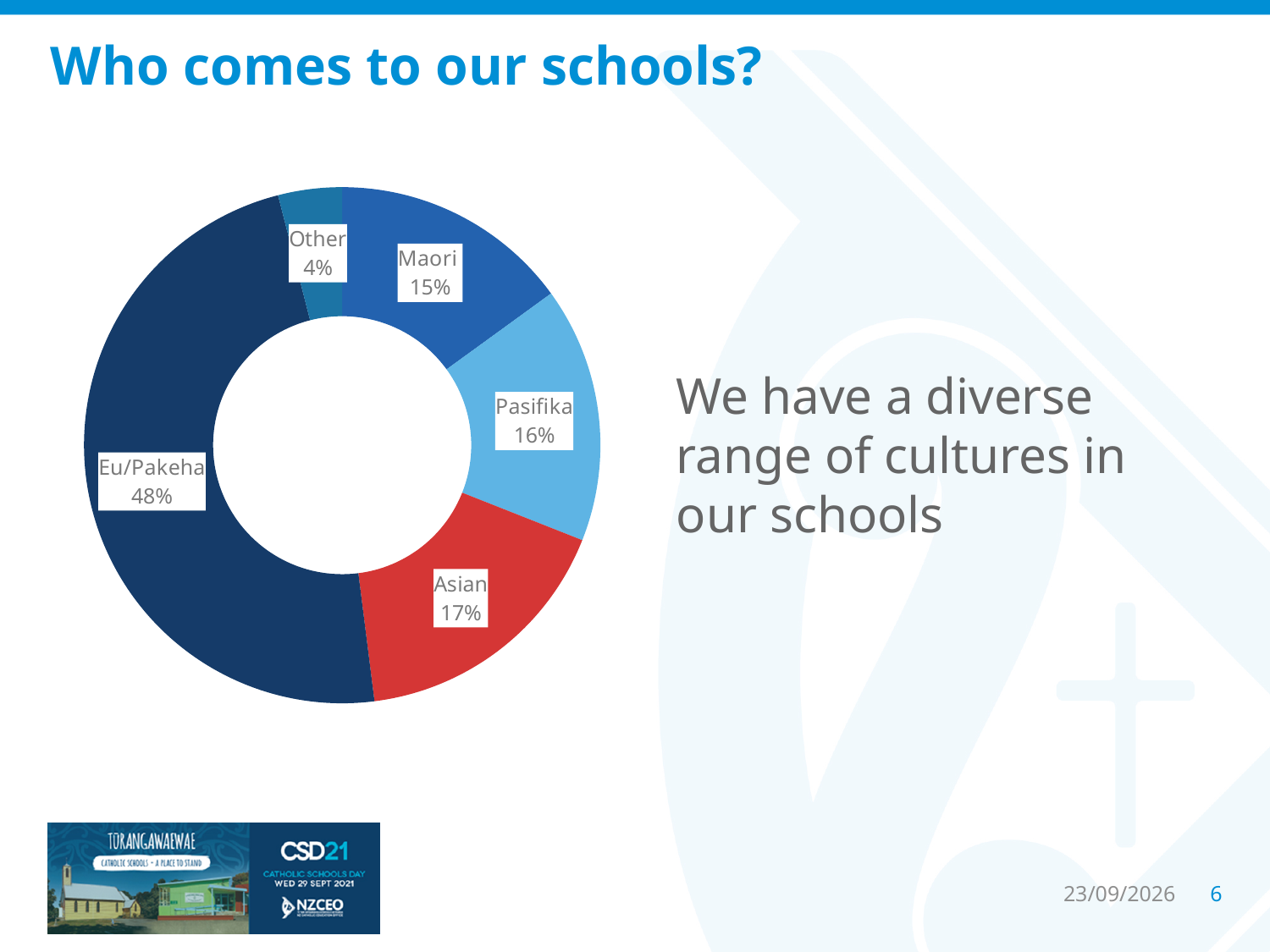
What colour is the Asian segment of the chart? Red How many categories are shown in the chart? 5 What is the difference in percentage points between Eu/Pakeha and Asian? 31 What percentage of the chart is Other? 4% What percentage of the chart is Pasifika? 16% Which is larger, the share for Asian or the share for Maori? Asian What kind of chart is shown on the slide? Doughnut chart What percentage of the chart is Asian? 17% Which category has the smallest share of the chart? Other What percentage of the chart is Eu/Pakeha? 48% Which category has the largest share of the chart? Eu/Pakeha What percentage of the chart is Maori? 15%